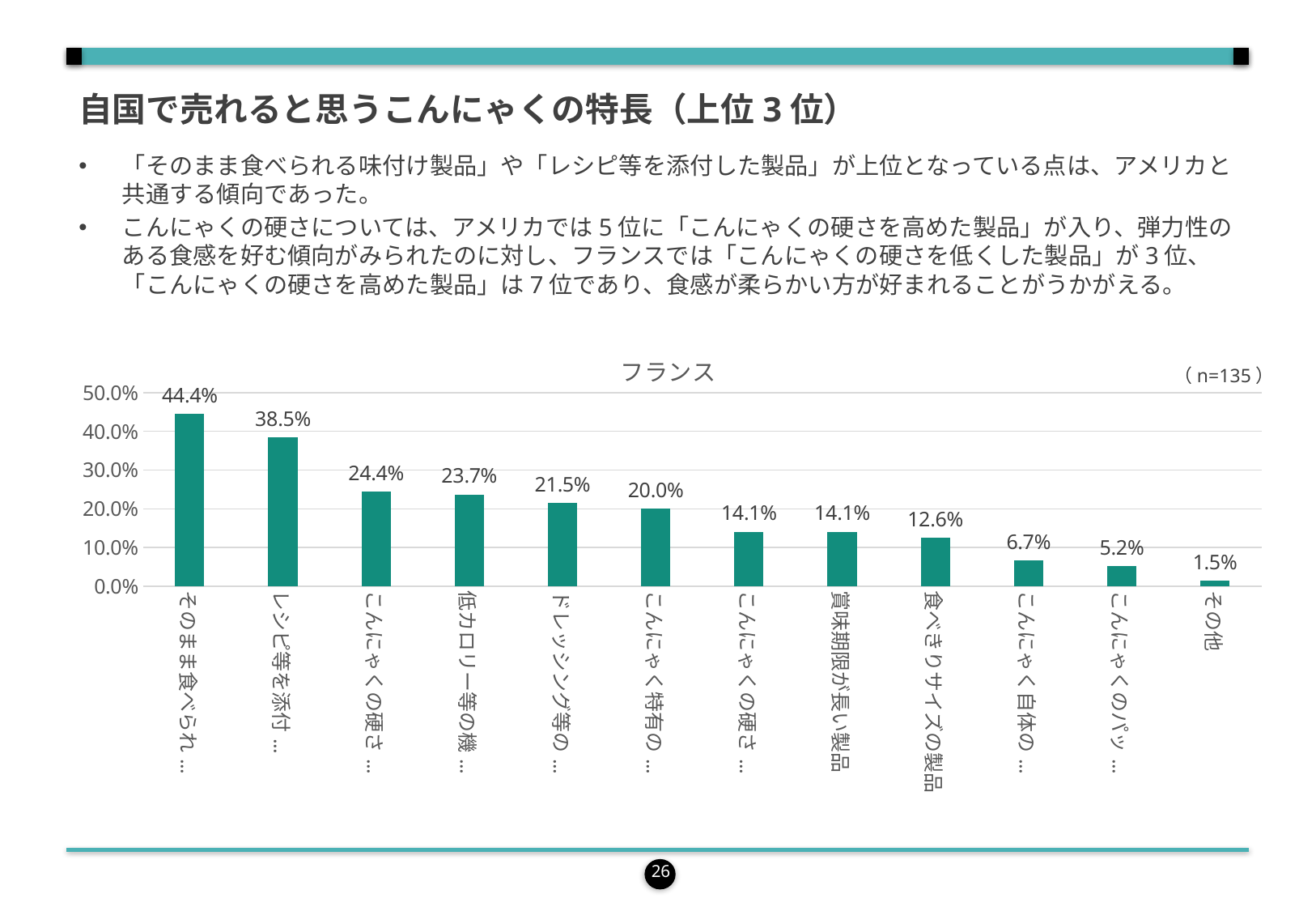
What is the highest value shown in the chart? 44.4% What is the difference between the values for 食べきりサイズの製品 and その他? 11.1 percentage points What is the value for その他? 1.5% What kind of chart is shown on the slide? bar chart Which is larger, the value for 賞味期限が長い製品 or the value for 食べきりサイズの製品? 賞味期限が長い製品 What is the difference between the highest value (44.4%) and the second highest value (38.5%)? 5.9 percentage points What is the value for 食べきりサイズの製品? 12.6% How many categories are plotted in the chart? 12 What is the value for 賞味期限が長い製品? 14.1% Is the value for 食べきりサイズの製品 greater or less than 10.0%? greater Which category has the lowest value? その他 Do the values rise or fall from left to right along the x axis? fall